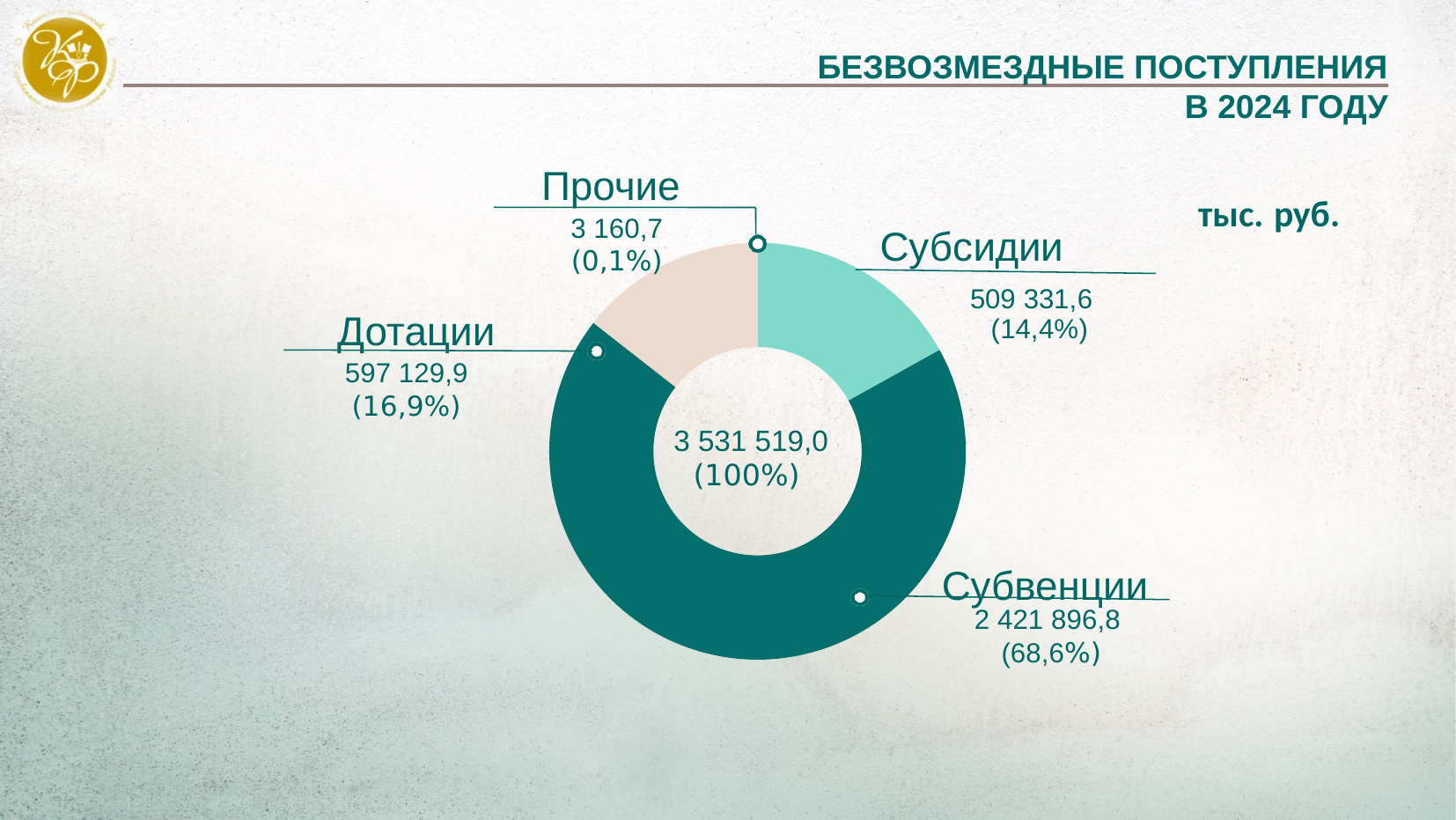
Which category has the largest value? Субвенции What is the value for Дотации? 597 129,9 Which is larger, Дотации or Субсидии? Дотации What is the total shown in the centre of the chart? 3 531 519,0 What is the value for Субвенции? 2 421 896,8 Which category has the smallest value? Прочие What type of chart is shown on the slide? Donut (pie) chart How many categories are shown in the chart? 4 What share of the total do Субвенции make up? 68,6% What is the value for Субсидии? 509 331,6 What is the value for Прочие? 3 160,7 What share of the total do Дотации make up? 16,9%